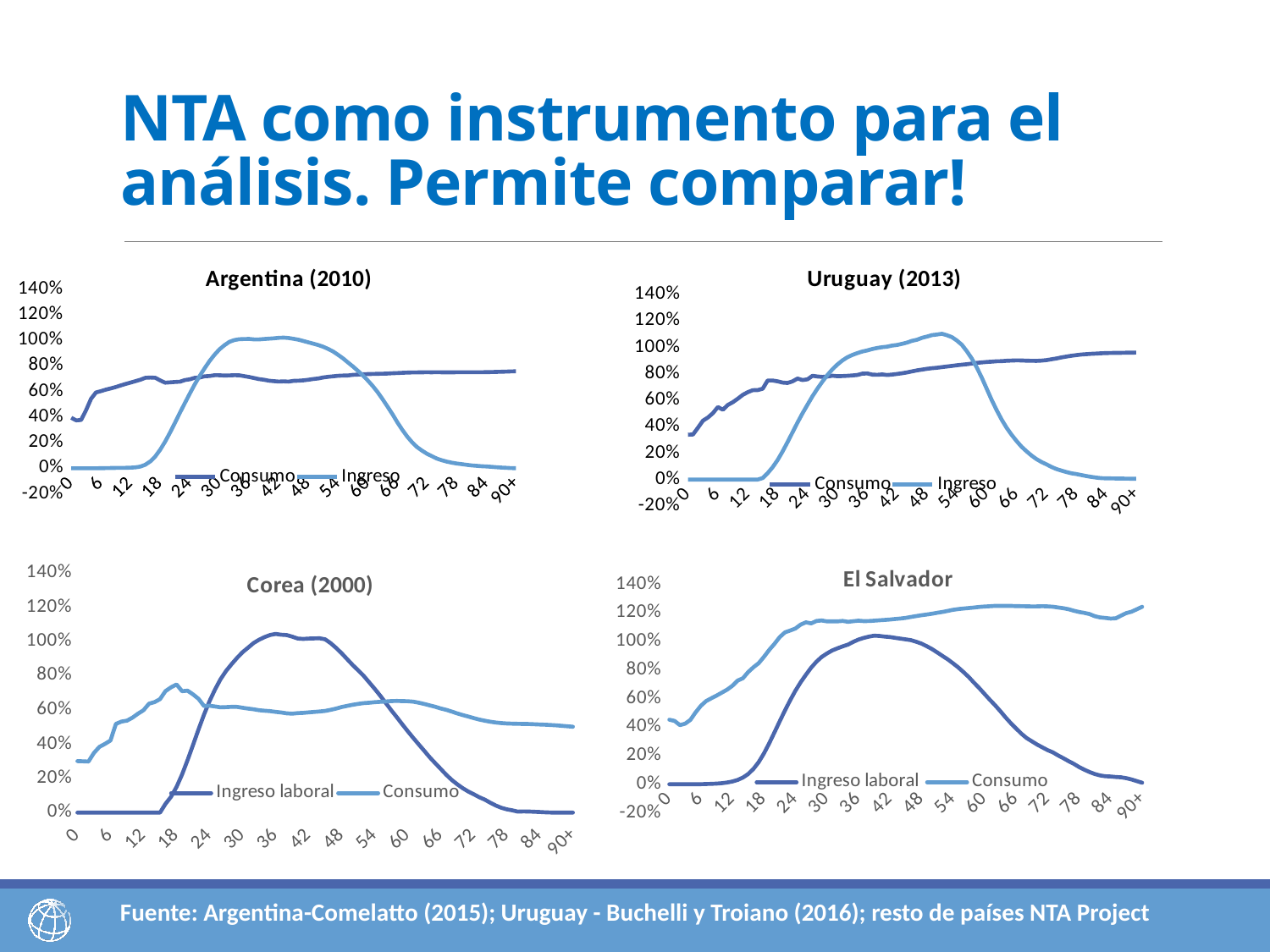
How many series does the legend of the Uruguay (2013) chart list? 2 In the El Salvador chart, is the value of Consumo at age 90+ greater or less than 100%? greater In the Uruguay (2013) chart, does the Consumo series generally rise or fall from age 0 to age 90+? rise In the Corea (2000) chart, what are the two series named in the legend? Ingreso laboral and Consumo In the Argentina (2010) chart, is the peak value of Ingreso greater or less than 80%? greater In the Argentina (2010) chart, at age 90+, which series has the larger value, Consumo or Ingreso? Consumo In the Corea (2000) chart, is the value of Consumo at age 0 greater or less than 20%? greater In the El Salvador chart, does the Ingreso laboral series rise or fall from age 42 to age 90+? fall In the Corea (2000) chart, at age 36, which series has the larger value, Ingreso laboral or Consumo? Ingreso laboral What kind of chart is the Argentina (2010) chart? line chart